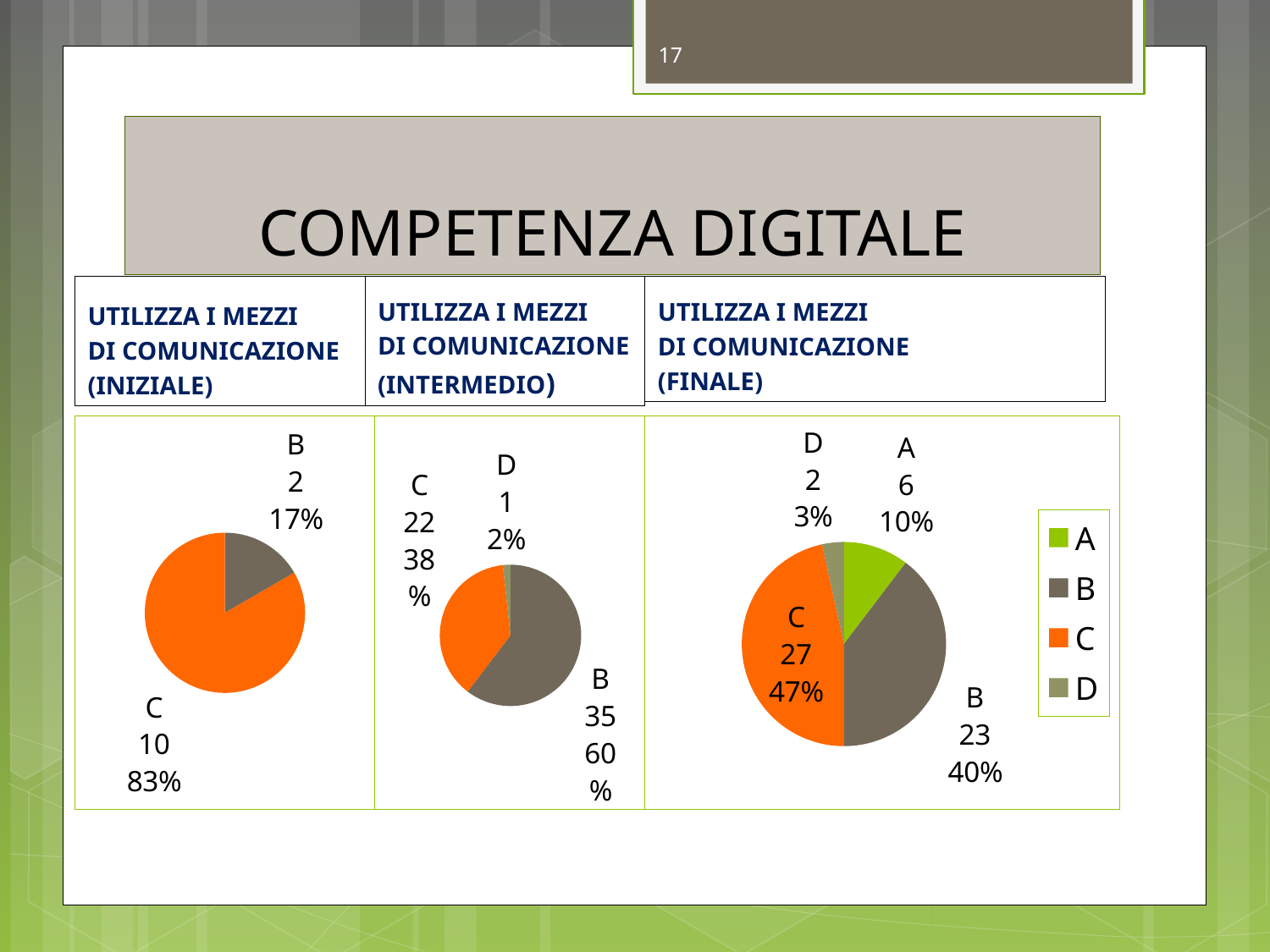
How many categories are shown in the FINALE pie chart? 4 What kind of chart is used for the INIZIALE data? Pie chart In the INTERMEDIO pie chart, what share of the pie does category C represent? 38% In the INTERMEDIO pie chart, which category has the smallest value? D In the INTERMEDIO pie chart, what is the value for category B? 35 How many entries does the legend on the right of the slide list? 4 In the FINALE pie chart, which category has the largest value? C In the FINALE pie chart, what is the difference between the values for C and B? 4 In the INIZIALE pie chart, what is the value for category C? 10 In the INIZIALE pie chart, what share of the pie does category B represent? 17% In the FINALE pie chart, which is larger, the value for B or the value for D? B In the FINALE pie chart, what is the value for category A? 6